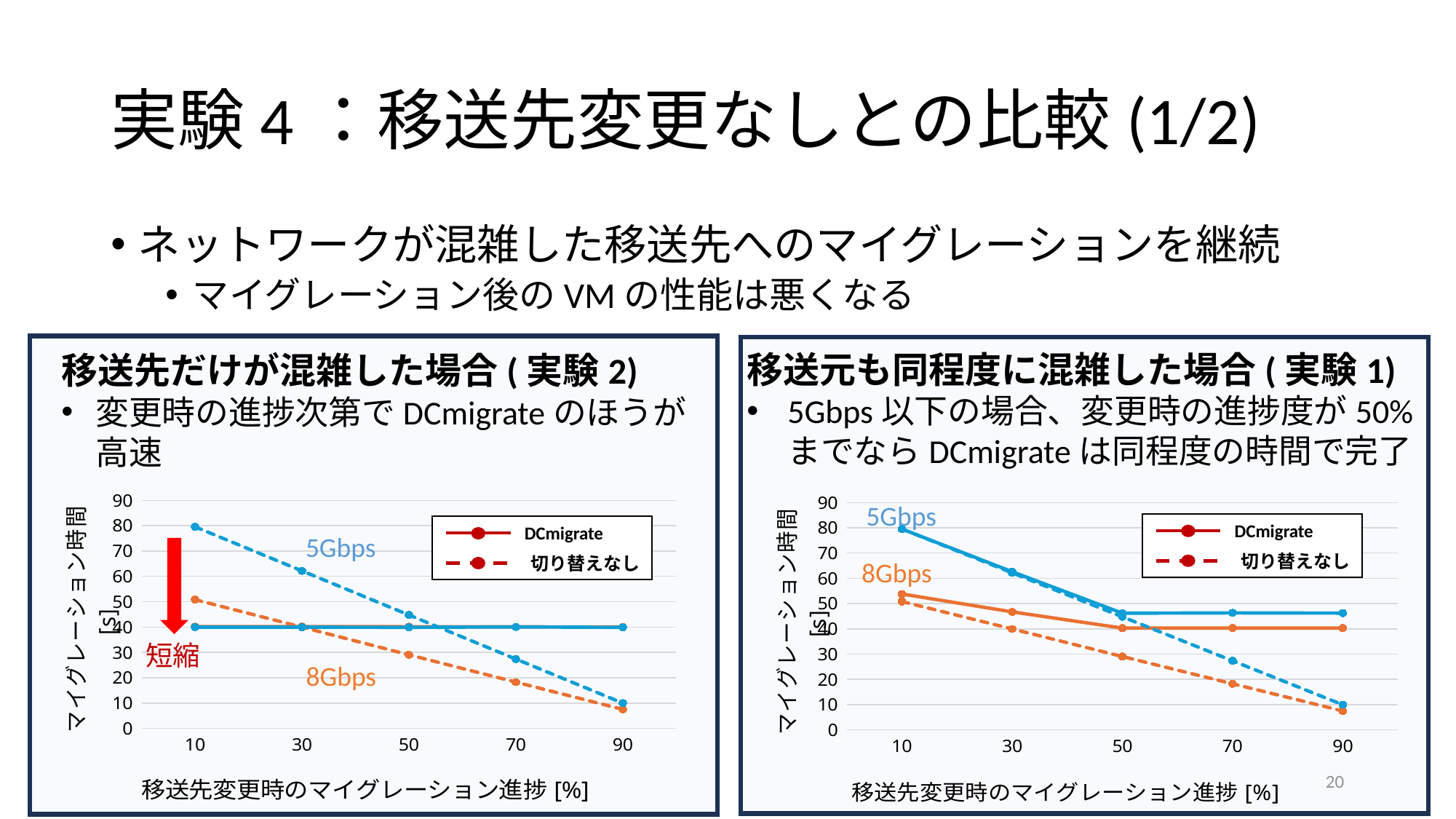
How many x-axis points (migration progress values) are plotted on the left chart? 5 How many series does the legend of the right chart (移送元も同程度に混雑した場合) list? 2 On the left chart, is the 8Gbps 切り替えなし value at 90% progress greater or less than 20? less On the left chart, does the 5Gbps 切り替えなし line rise or fall as migration progress increases? fall What kind of chart is the left chart (移送先だけが混雑した場合)? line chart On the left chart, at 90% progress, which is larger: the DCmigrate value or the 5Gbps 切り替えなし value? DCmigrate On the right chart, at 10% progress, which is larger: the 5Gbps DCmigrate value or the 8Gbps DCmigrate value? 5Gbps DCmigrate On the right chart, is the 5Gbps DCmigrate value at 30% progress greater or less than 50? greater What is the y-axis label of the right chart? マイグレーション時間 [s]